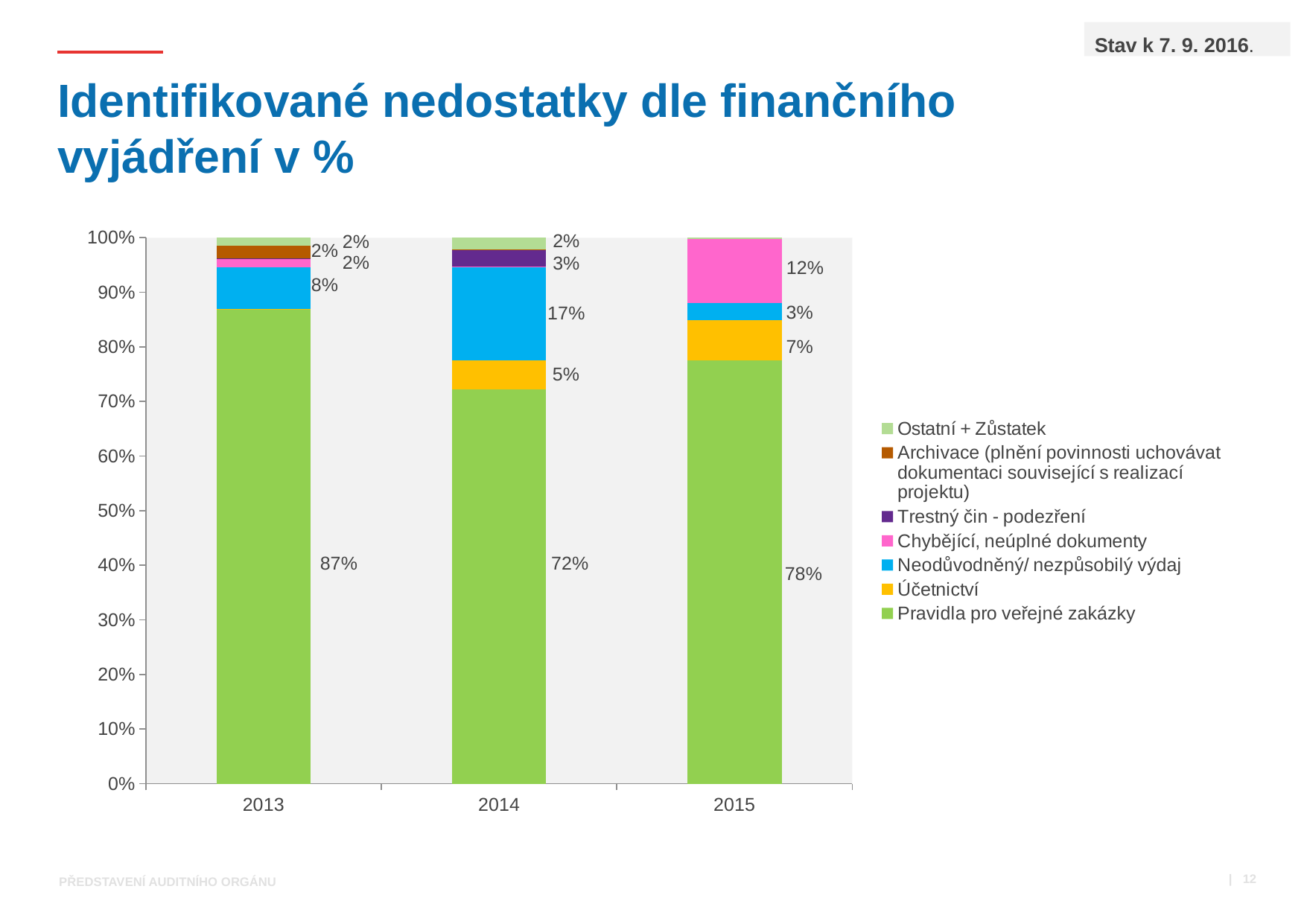
What is the value for Trestný čin - podezření in 2014? 3% Is the share of Neodůvodněný/ nezpůsobilý výdaj larger in 2014 or in 2015? 2014 In which year is the share of Pravidla pro veřejné zakázky the highest? 2013 How many series does the legend list? 7 What percentage does Pravidla pro veřejné zakázky account for in 2013? 87% What is the value for Neodůvodněný/ nezpůsobilý výdaj in 2014? 17% What is the value for Účetnictví in 2015? 7% What share do Chybějící, neúplné dokumenty have in 2015? 12% In which year is the share of Pravidla pro veřejné zakázky the lowest? 2014 What type of chart is shown on the slide? Stacked bar chart How many years are shown on the x axis? 3 By how many percentage points does the share of Pravidla pro veřejné zakázky in 2013 exceed that in 2014? 15 percentage points